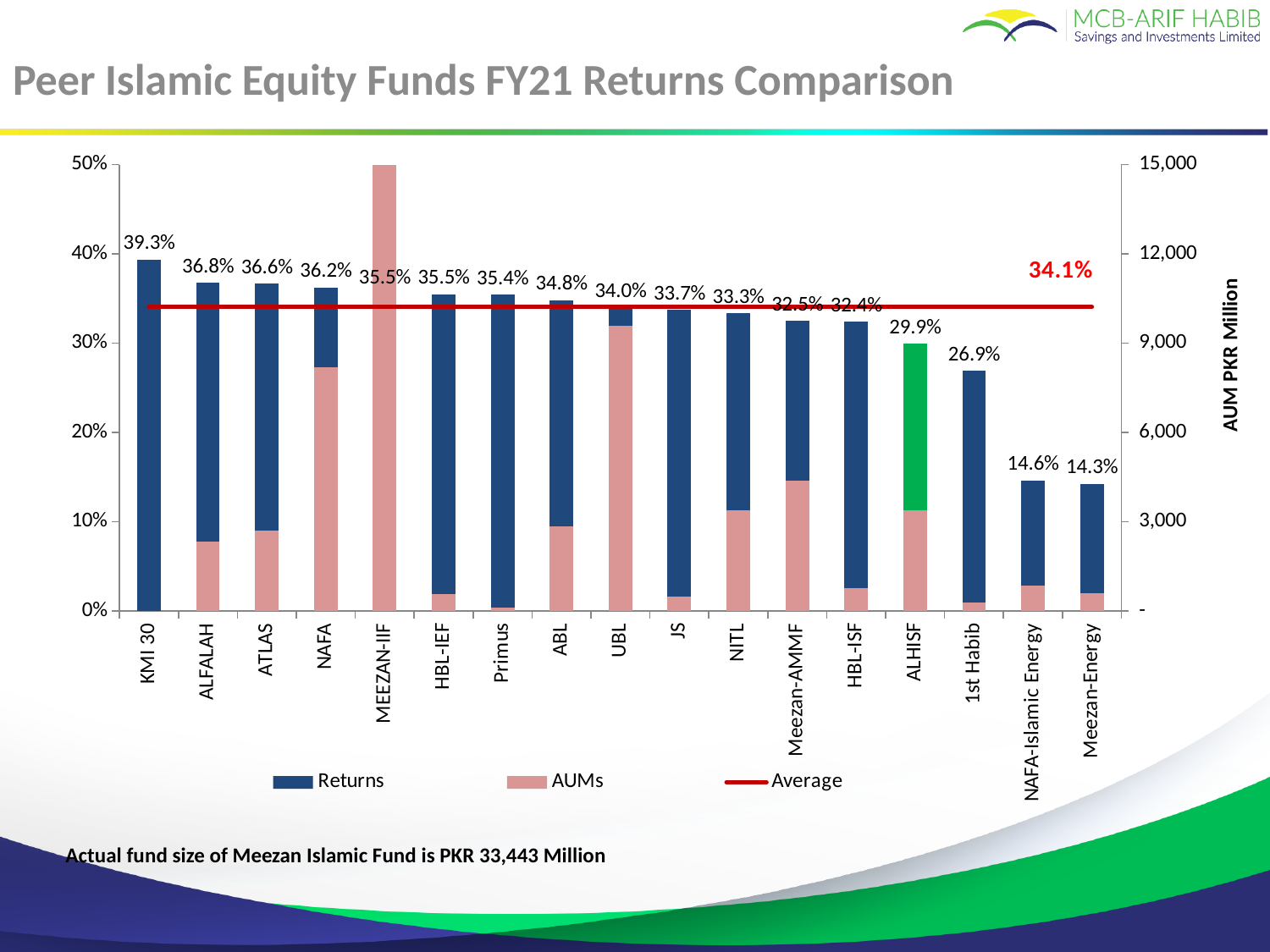
Do the returns rise or fall moving from left to right along the x axis? Fall Which has the higher return, ALFALAH or ATLAS? ALFALAH Which fund or index has the highest return on the chart? KMI 30 How many funds or indices are shown on the x axis? 17 What is the difference between the return of KMI 30 and the return of Meezan-Energy? 25.0% What kind of chart is used to show the returns? Bar chart Which fund has the lowest return on the chart? Meezan-Energy How many series does the legend list? 3 What is the return shown for ALHISF? 29.9% Is the AUM value for NAFA greater or less than 6,000? greater What value does the Average line show? 34.1% What is the FY21 return shown for KMI 30? 39.3%